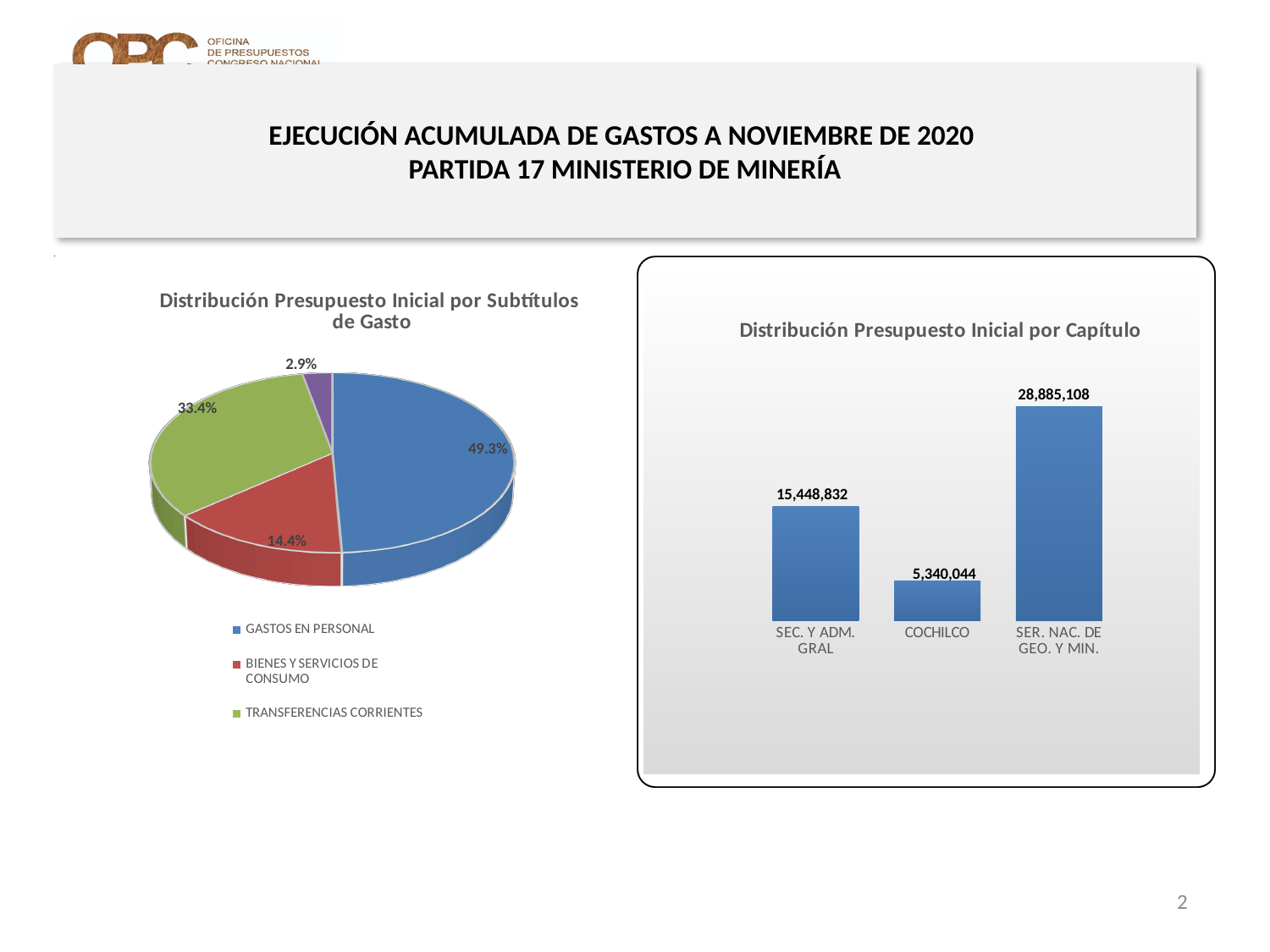
What kind of chart is 'Distribución Presupuesto Inicial por Subtítulos de Gasto'? Pie chart In the 'Distribución Presupuesto Inicial por Subtítulos de Gasto' pie chart, what share does TRANSFERENCIAS CORRIENTES have? 33.4% In the 'Distribución Presupuesto Inicial por Capítulo' chart, which category has the highest value? SER. NAC. DE GEO. Y MIN. In the 'Distribución Presupuesto Inicial por Subtítulos de Gasto' pie chart, what share does GASTOS EN PERSONAL have? 49.3% In the 'Distribución Presupuesto Inicial por Capítulo' chart, what is the difference between SER. NAC. DE GEO. Y MIN. and SEC. Y ADM. GRAL? 13,436,276 How many categories are shown in the 'Distribución Presupuesto Inicial por Capítulo' chart? 3 In the 'Distribución Presupuesto Inicial por Capítulo' chart, what is the value for SEC. Y ADM. GRAL? 15,448,832 How many entries does the legend of the 'Distribución Presupuesto Inicial por Subtítulos de Gasto' pie chart list? 3 In the 'Distribución Presupuesto Inicial por Capítulo' chart, which is larger: SEC. Y ADM. GRAL or COCHILCO? SEC. Y ADM. GRAL What kind of chart is 'Distribución Presupuesto Inicial por Capítulo'? Bar chart In the 'Distribución Presupuesto Inicial por Capítulo' chart, which category has the lowest value? COCHILCO In the 'Distribución Presupuesto Inicial por Capítulo' chart, what is the value for COCHILCO? 5,340,044